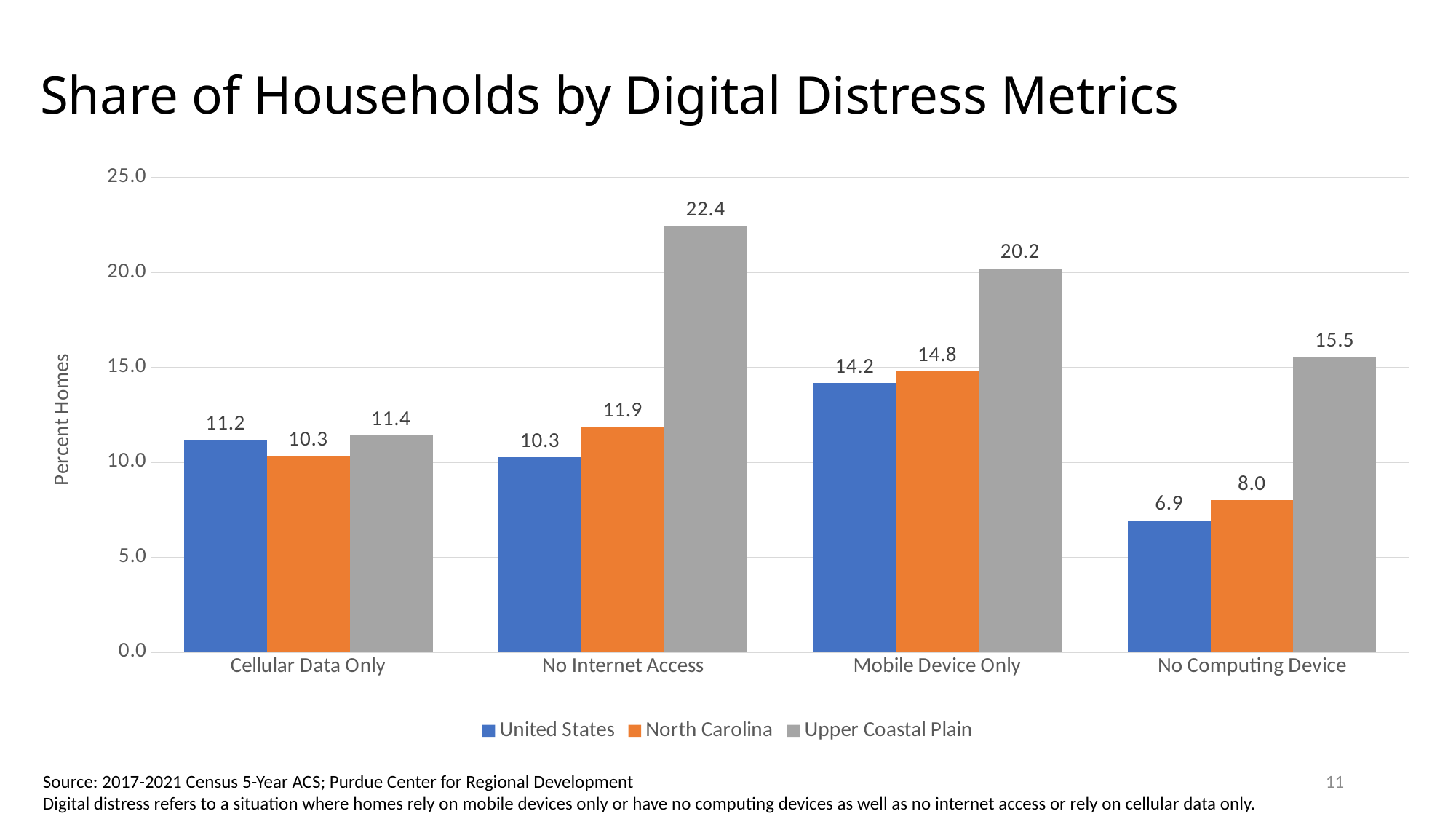
Which category has the highest value for Upper Coastal Plain? No Internet Access Which category has the lowest value for North Carolina? No Computing Device What is the value for North Carolina in the Mobile Device Only category? 14.8 Which is larger in the Cellular Data Only category: United States or North Carolina? United States How many categories are shown on the x axis? 4 How many series does the legend list? 3 What is the value for United States in the No Computing Device category? 6.9 What kind of chart is shown on the slide? Bar chart Is the value for Upper Coastal Plain in the Mobile Device Only category greater or less than 20.0? greater What is the value for Upper Coastal Plain in the No Internet Access category? 22.4 What is the difference between the Upper Coastal Plain and United States values in the No Internet Access category? 12.1 What is the label of the y axis? Percent Homes